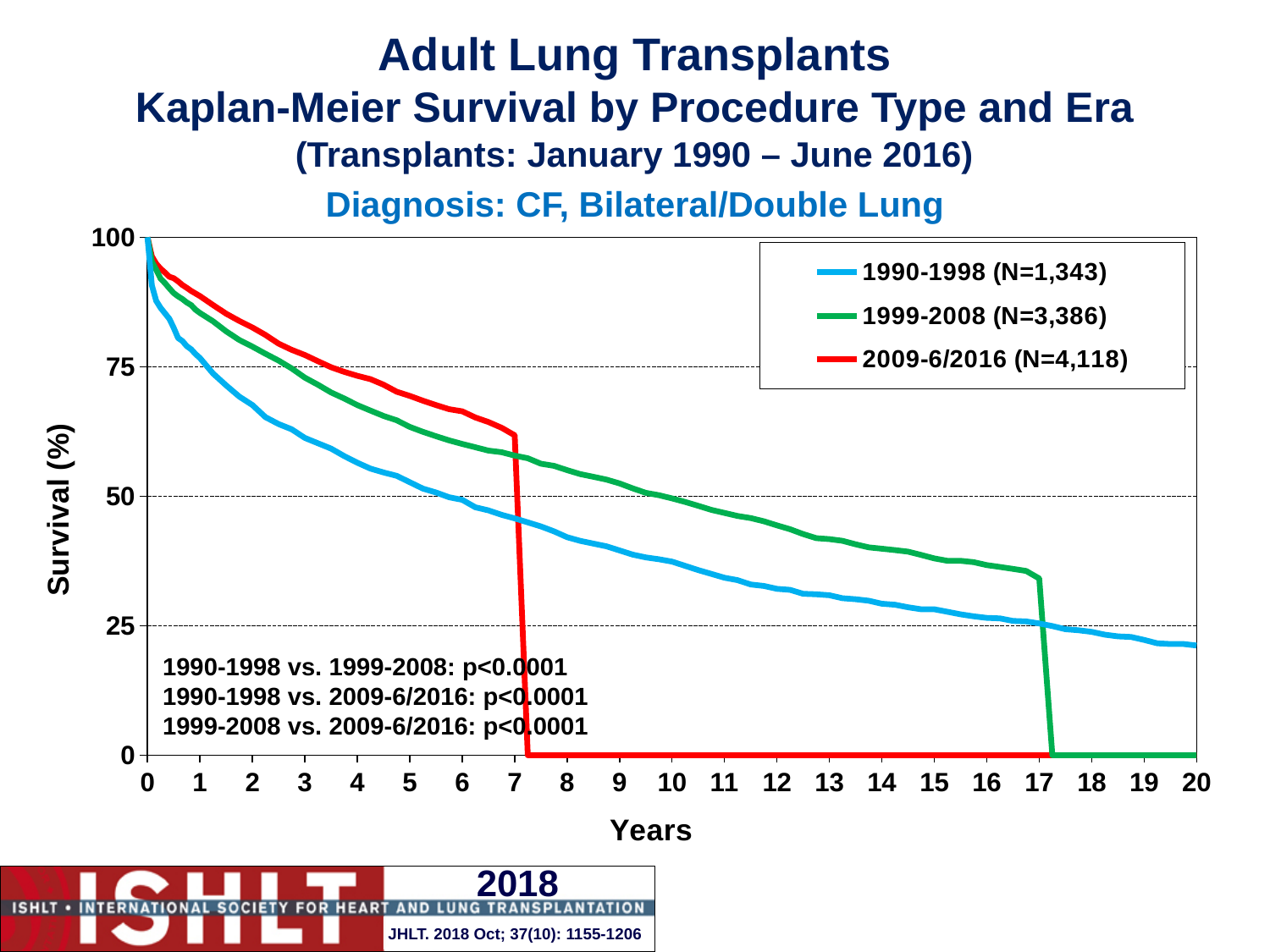
At 10 years, which series has higher survival: 1990-1998 or 1999-2008? 1999-2008 Is the survival value for the 2009-6/2016 series at 1 year greater or less than 75? greater Is the survival value for the 1999-2008 series at 15 years greater or less than 25? greater What is the N value shown in the legend for the 1999-2008 era? N=3,386 How many series does the legend list? 3 Is the survival value for the 1990-1998 series at 10 years greater or less than 50? less Do the survival curves rise or fall as years increase along the x axis? Fall Which era is represented by the red line in the legend? 2009-6/2016 (N=4,118) At 5 years, which series has higher survival: 1990-1998 or 2009-6/2016? 2009-6/2016 What kind of chart is shown on the slide? Line chart